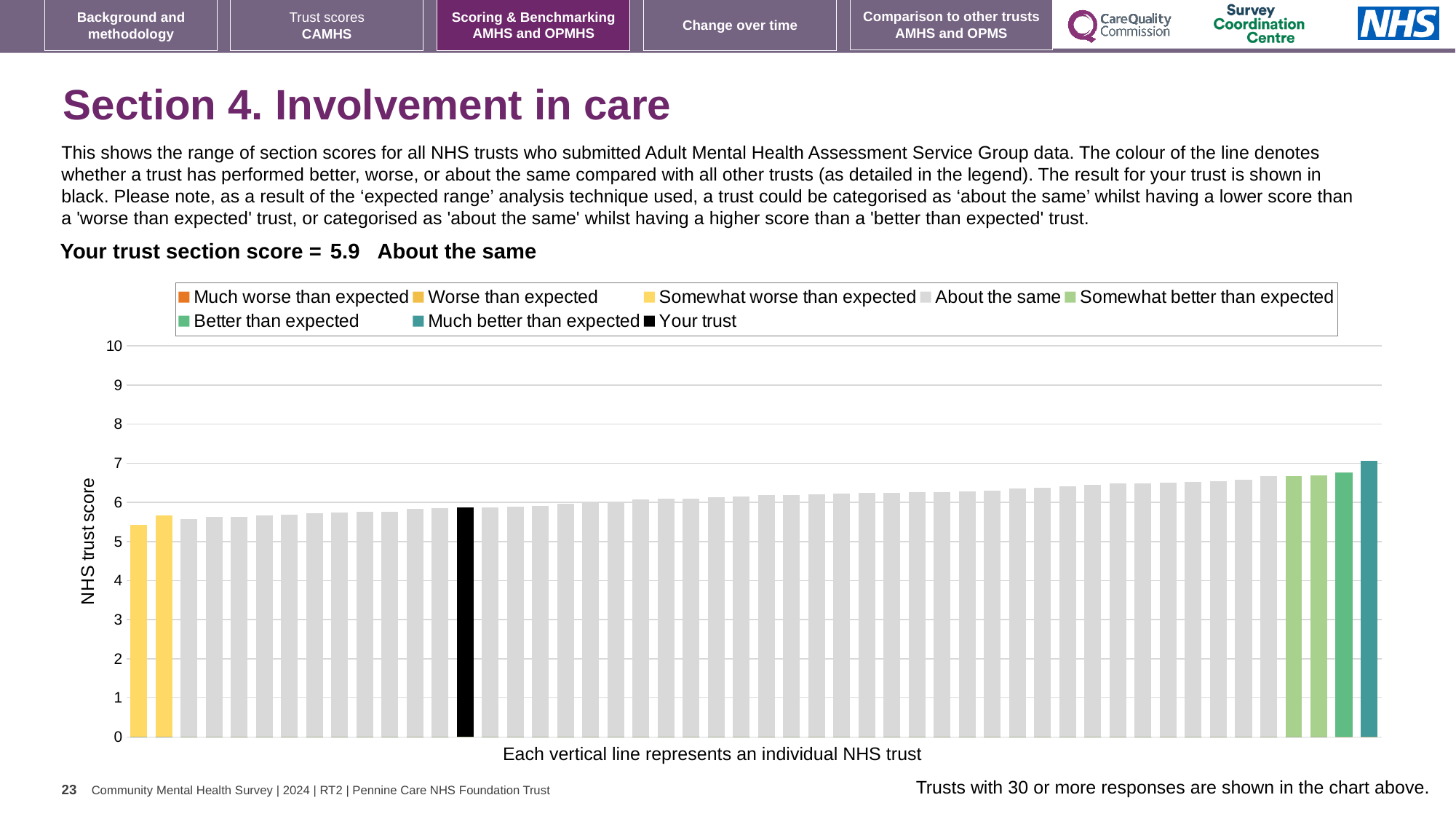
Is the value of the highest bar in the chart greater or less than 8? less Which legend category does the lowest bar in the chart belong to? Somewhat worse than expected How many bars are coloured as 'Worse than expected'? 0 What is the label on the vertical axis of the chart? NHS trust score What is the section score for your trust shown on the slide? 5.9 Is the value of the lowest bar in the chart greater or less than 5? greater Do the bar values rise or fall from left to right along the x axis? rise Which legend category does the highest bar in the chart belong to? Much better than expected What kind of chart is shown on the slide? bar chart Is the value for your trust greater or less than 5? greater Which performance category is your trust placed in for this section? About the same How many entries does the chart legend list? 8